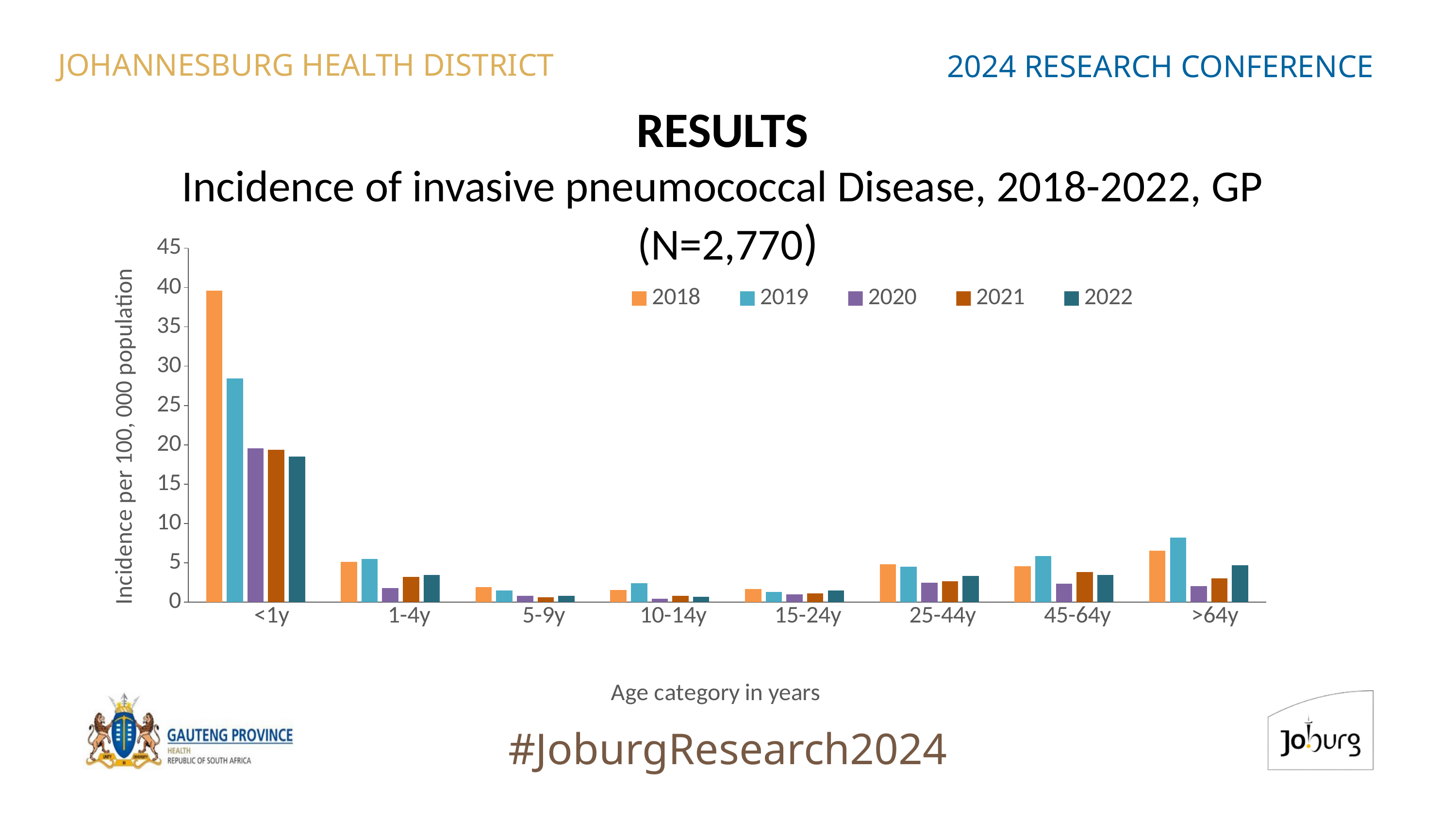
How many series does the legend list? 5 What is the label of the x axis? Age category in years For the >64y age category, which year has the higher incidence, 2019 or 2020? 2019 What kind of chart is shown on the slide? bar chart Is the 2019 incidence for the <1y age category greater or less than 30? less For the <1y age category, which year has the higher incidence, 2018 or 2019? 2018 How many age categories are shown on the x axis? 8 Is the 2020 incidence for the <1y age category greater or less than 15? greater For the >64y age category, which year has the lowest incidence? 2020 What is the label of the y axis? Incidence per 100, 000 population Is the 2018 incidence for the <1y age category greater or less than 35? greater Which age category has the highest incidence for 2018? <1y